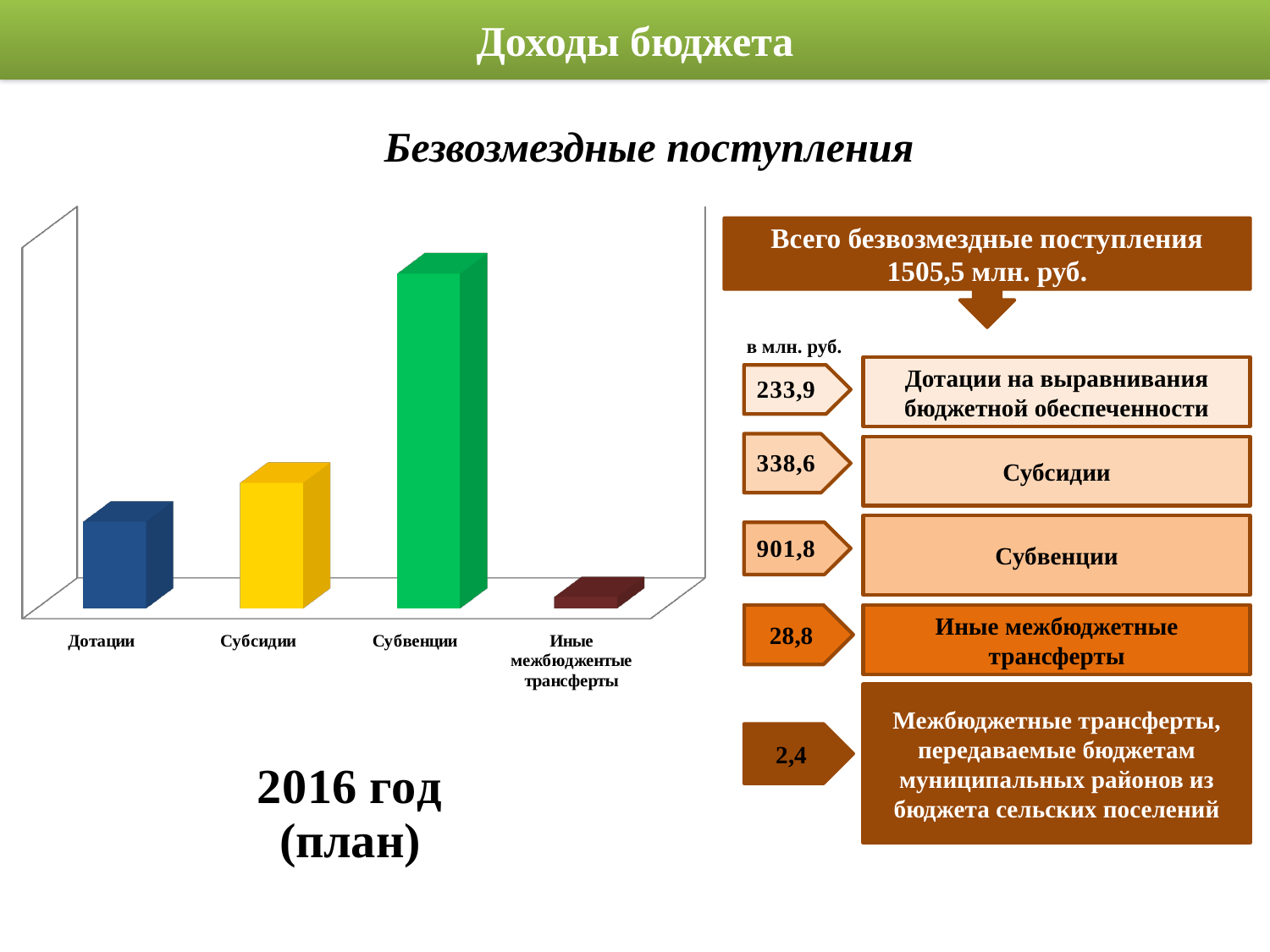
What kind of chart is shown on the slide? bar chart What colour is the bar for Субвенции? green According to the slide, what is the value for Субсидии in млн. руб.? 338,6 What year and plan status is stated below the chart? 2016 год (план) How many categories are shown on the bar chart? 4 What is the difference between the values for Субвенции and Субсидии shown on the slide? 563,2 According to the slide, what is the value for Иные межбюджетные трансферты in млн. руб.? 28,8 Which category has the tallest bar in the chart? Субвенции Which bar is taller, Дотации or Субсидии? Субсидии Which bar is taller, Субвенции or Субсидии? Субвенции Which category has the shortest bar in the chart? Иные межбюджентые трансферты According to the slide, what is the value for Субвенции in млн. руб.? 901,8